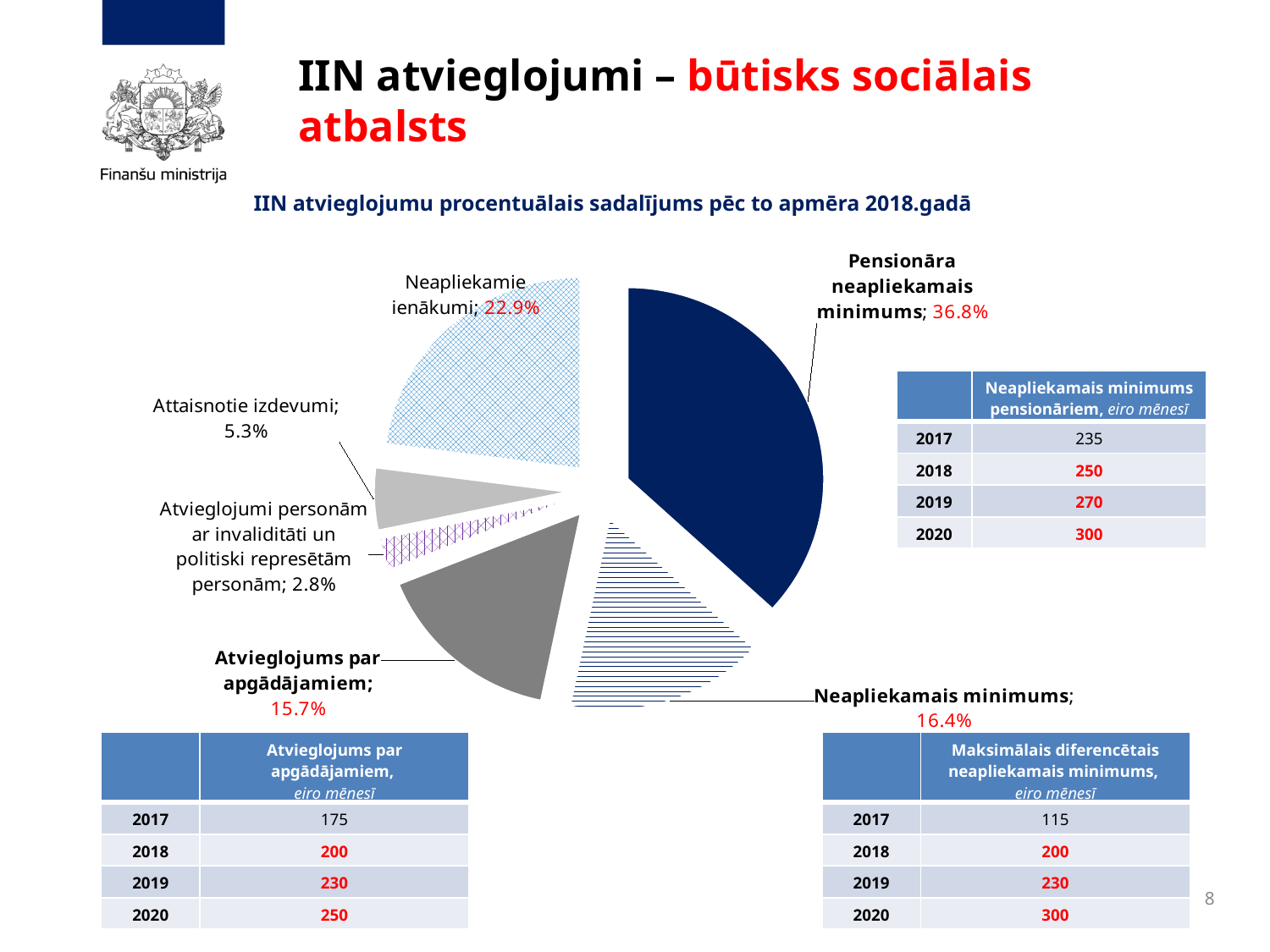
Which slice of the pie chart is the smallest? Atvieglojumi personām ar invaliditāti un politiski represētām personām What type of chart is shown on the slide? Pie chart What is the difference in percentage points between 'Pensionāra neapliekamais minimums' and 'Neapliekamais minimums'? 20.4 How many slices does the pie chart have? 6 What share of the pie is 'Atvieglojums par apgādājamiem'? 15.7% What share of the pie is 'Attaisnotie izdevumi'? 5.3% Which is larger in the pie chart: 'Neapliekamie ienākumi' or 'Atvieglojums par apgādājamiem'? Neapliekamie ienākumi What share of the pie is 'Pensionāra neapliekamais minimums'? 36.8% What share of the pie is 'Neapliekamie ienākumi'? 22.9% What is the title of the pie chart? IIN atvieglojumu procentuālais sadalījums pēc to apmēra 2018.gadā Which slice of the pie chart is the largest? Pensionāra neapliekamais minimums What share of the pie is 'Atvieglojumi personām ar invaliditāti un politiski represētām personām'? 2.8%